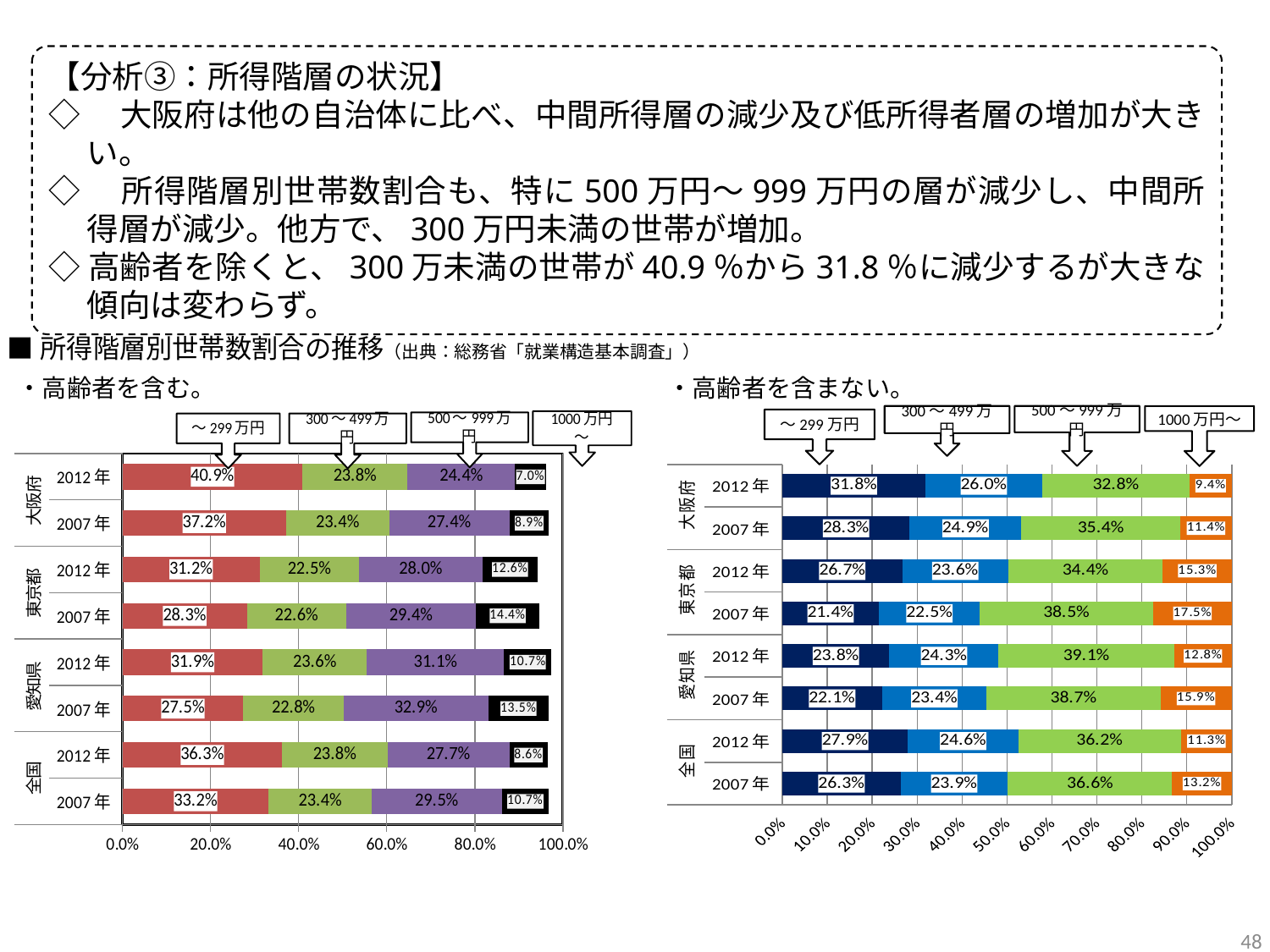
In the left chart (高齢者を含む), what is the value of the 1000万円～ segment for 愛知県 in 2007年? 13.5% In the left chart (高齢者を含む), what is the value of the ～299万円 segment for 大阪府 in 2012年? 40.9% In the right chart (高齢者を含まない), which is larger: the 500～999万円 value for 愛知県 in 2012年 or for 全国 in 2012年? 愛知県 2012年 How many income-bracket series are shown in the right chart (高齢者を含まない)? 4 In the left chart (高齢者を含む), what is the difference between the ～299万円 values for 大阪府 in 2012年 and 2007年? 3.7% In the right chart (高齢者を含まない), what is the value of the 500～999万円 segment for 東京都 in 2007年? 38.5% In the left chart (高齢者を含む), which bar has the lowest 1000万円～ value? 大阪府 2012年 In the left chart (高齢者を含む), is the 500～999万円 value for 大阪府 in 2007年 larger or smaller than in 2012年? larger In the right chart (高齢者を含まない), what is the difference between the 1000万円～ values for 東京都 in 2007年 and 2012年? 2.2% What type of chart is used on this slide? Stacked bar chart How many bars are plotted in the left chart (高齢者を含む)? 8 In the right chart (高齢者を含まない), which bar has the highest ～299万円 value? 大阪府 2012年